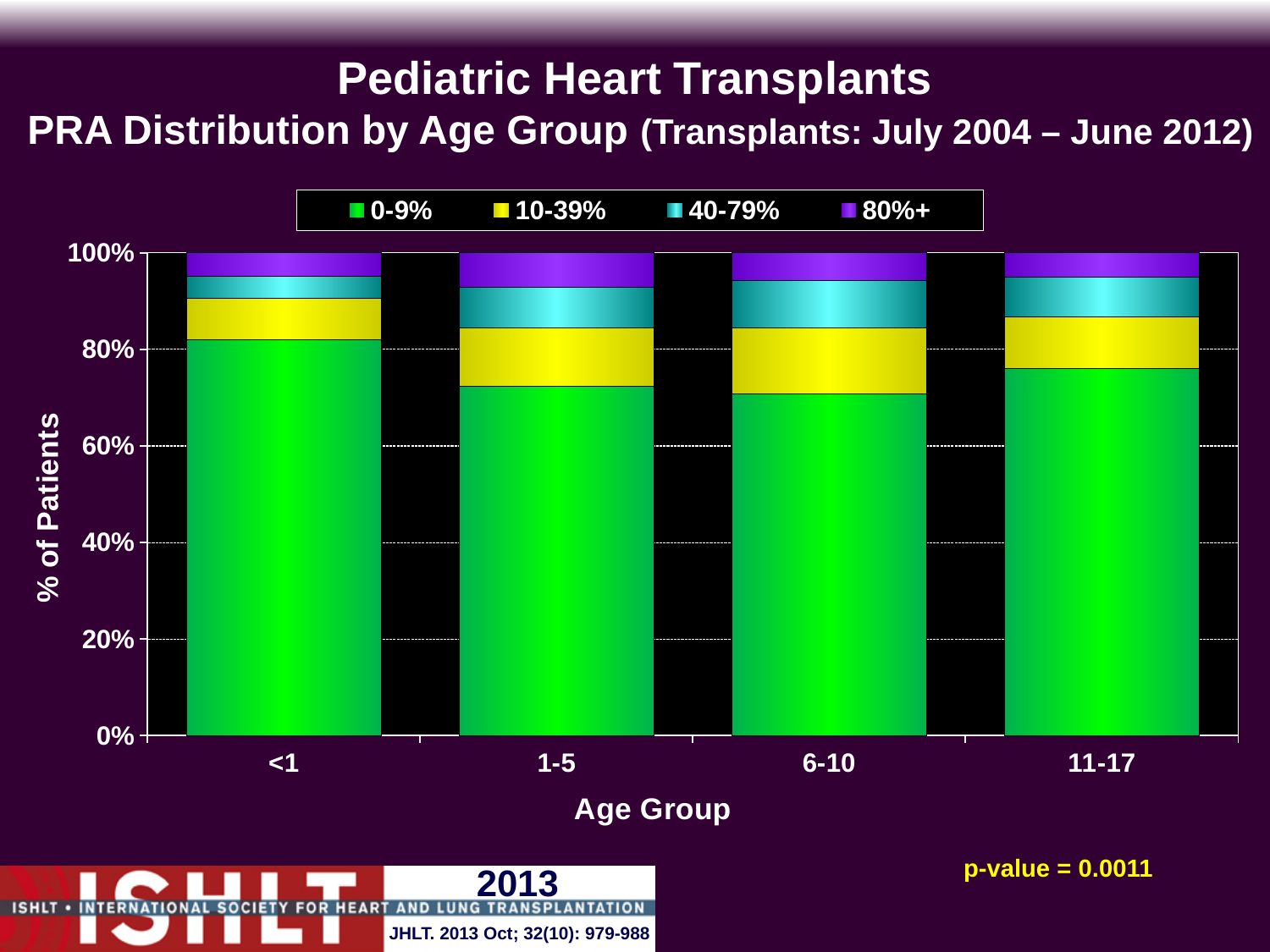
What is the label of the y axis? % of Patients Is the 0-9% share for the <1 age group greater or less than 60%? greater Which has a larger 0-9% PRA segment, the 11-17 age group or the 6-10 age group? 11-17 Which age group has the largest 0-9% PRA segment? <1 Which age group has the smallest 10-39% PRA segment? <1 What p-value is reported on the slide? 0.0011 How many series does the legend list? 4 Which has a larger 0-9% PRA segment, the <1 age group or the 6-10 age group? <1 How many age groups are shown on the x axis? 4 What is the total height of each stacked bar on the y axis? 100% What kind of chart is shown on the slide? Stacked bar chart Is the 0-9% share for the 6-10 age group greater or less than 80%? less